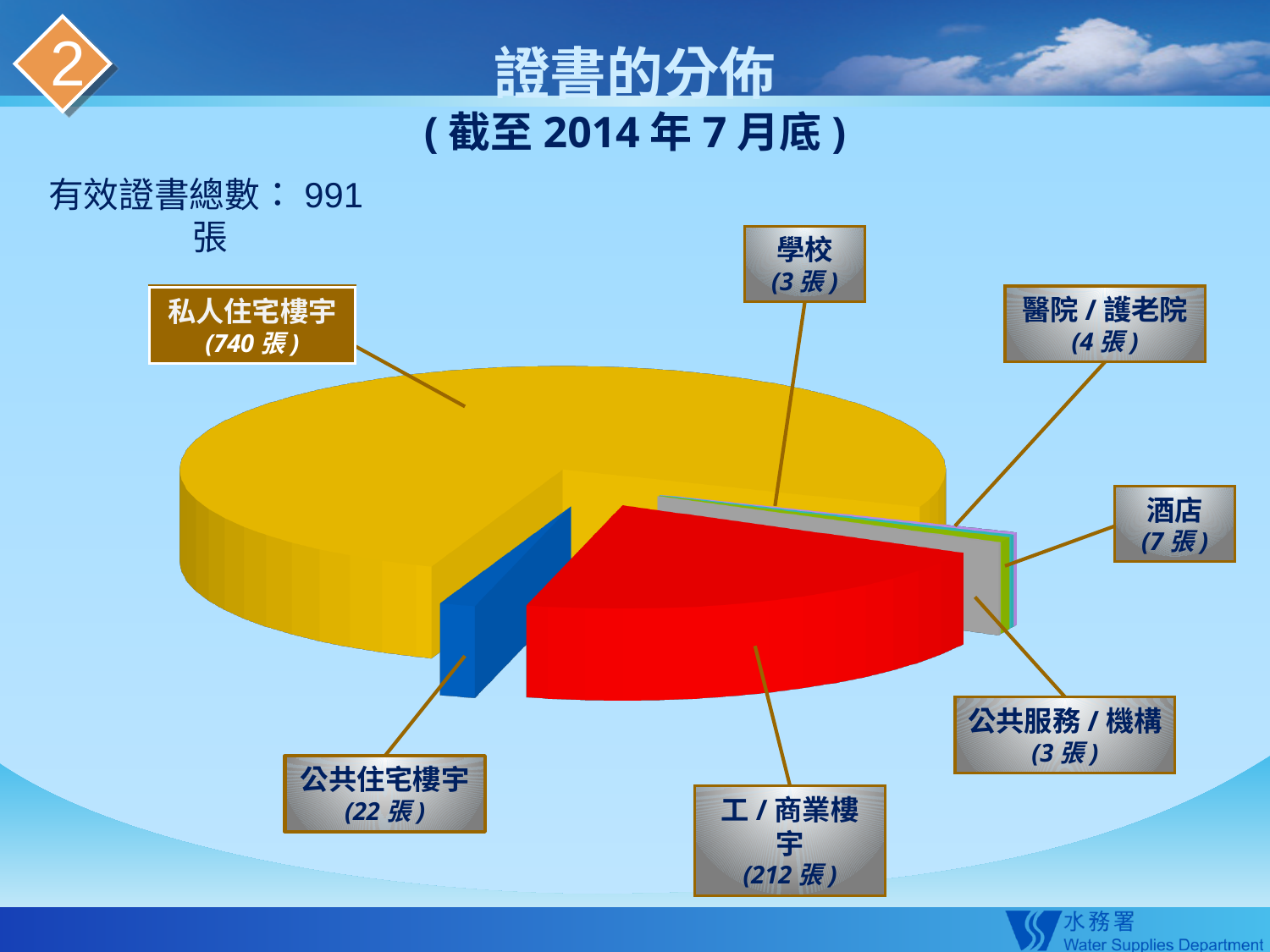
How many certificates does the pie chart show for 醫院 / 護老院? 4 張 What is the total number of valid certificates stated on the slide? 991 張 What is the difference in certificates between 私人住宅樓宇 and 工 / 商業樓宇? 528 張 How many certificates does the pie chart show for 工 / 商業樓宇? 212 張 Which category has the largest slice of the pie chart? 私人住宅樓宇 How many certificates does the pie chart show for 酒店? 7 張 How many certificates does the pie chart show for 私人住宅樓宇? 740 張 What type of chart is shown on the slide? Pie chart What is the difference in certificates between 酒店 and 學校? 4 張 Which has more certificates, 公共住宅樓宇 or 酒店? 公共住宅樓宇 How many categories are shown in the pie chart? 7 How many certificates does the pie chart show for 公共住宅樓宇? 22 張